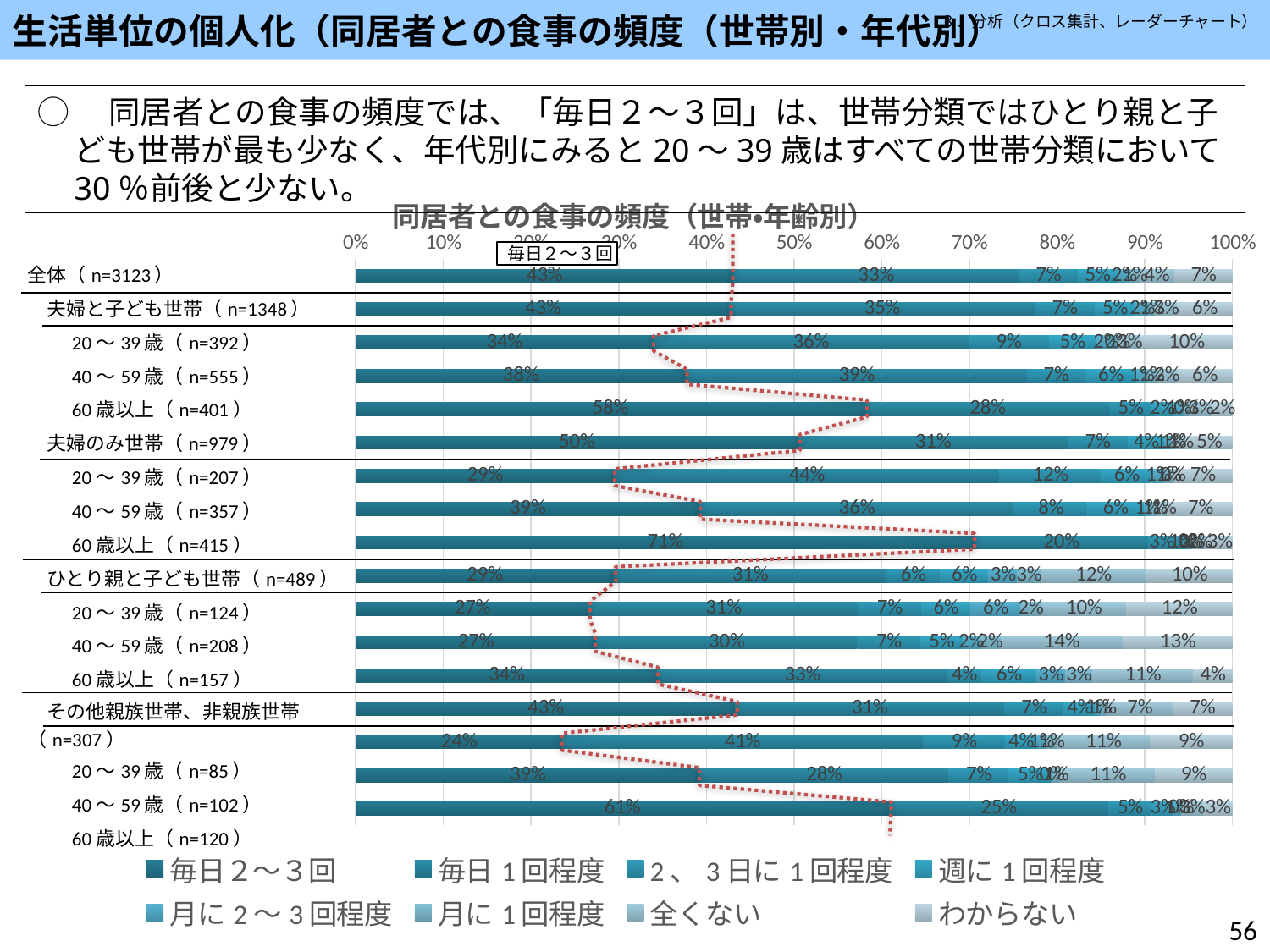
What is the difference in 毎日２～３回 between 夫婦のみ世帯 60歳以上 (n=415) and 夫婦と子ども世帯 60歳以上 (n=401)? 13 percentage points What is the value of 毎日１回程度 for 夫婦のみ世帯 20～39歳 (n=207)? 44% What type of chart is shown on the slide? bar chart For 全体 (n=3123), which is larger: 毎日２～３回 or 毎日１回程度? 毎日２～３回 What is the value of 毎日２～３回 for 夫婦のみ世帯 60歳以上 (n=415)? 71% What is the value of 毎日２～３回 for 全体 (n=3123)? 43% How many category bars are plotted in the chart? 17 What is the title of the chart? 同居者との食事の頻度（世帯•年齢別） Which series is listed first in the legend? 毎日２～３回 How many series does the legend list? 8 Which category has the highest value for 毎日２～３回? 夫婦のみ世帯 60歳以上 (n=415) What is the value of 毎日２～３回 for ひとり親と子ども世帯 (n=489)? 29%